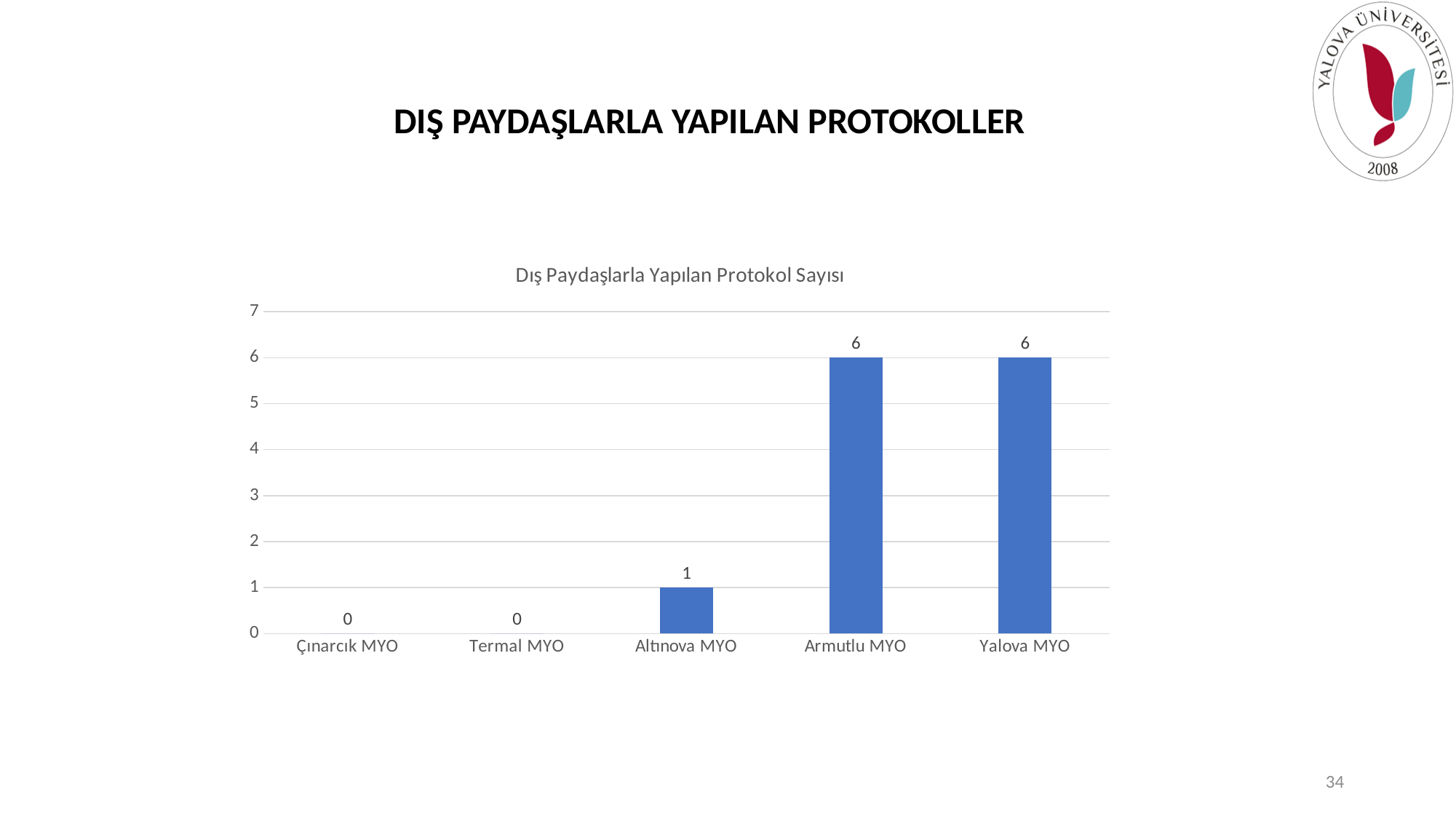
What is the highest value shown on the y axis? 7 What is the value for Altınova MYO? 1 What is the value for Termal MYO? 0 What kind of chart is shown on the slide? bar chart What is the difference between the values for Armutlu MYO and Altınova MYO? 5 How many categories are shown on the x axis? 5 What is the value for Armutlu MYO? 6 What is the value for Çınarcık MYO? 0 Is the value for Yalova MYO greater or less than 4? greater What is the title of the chart? Dış Paydaşlarla Yapılan Protokol Sayısı Which is larger, the value for Altınova MYO or the value for Termal MYO? Altınova MYO What is the value for Yalova MYO? 6